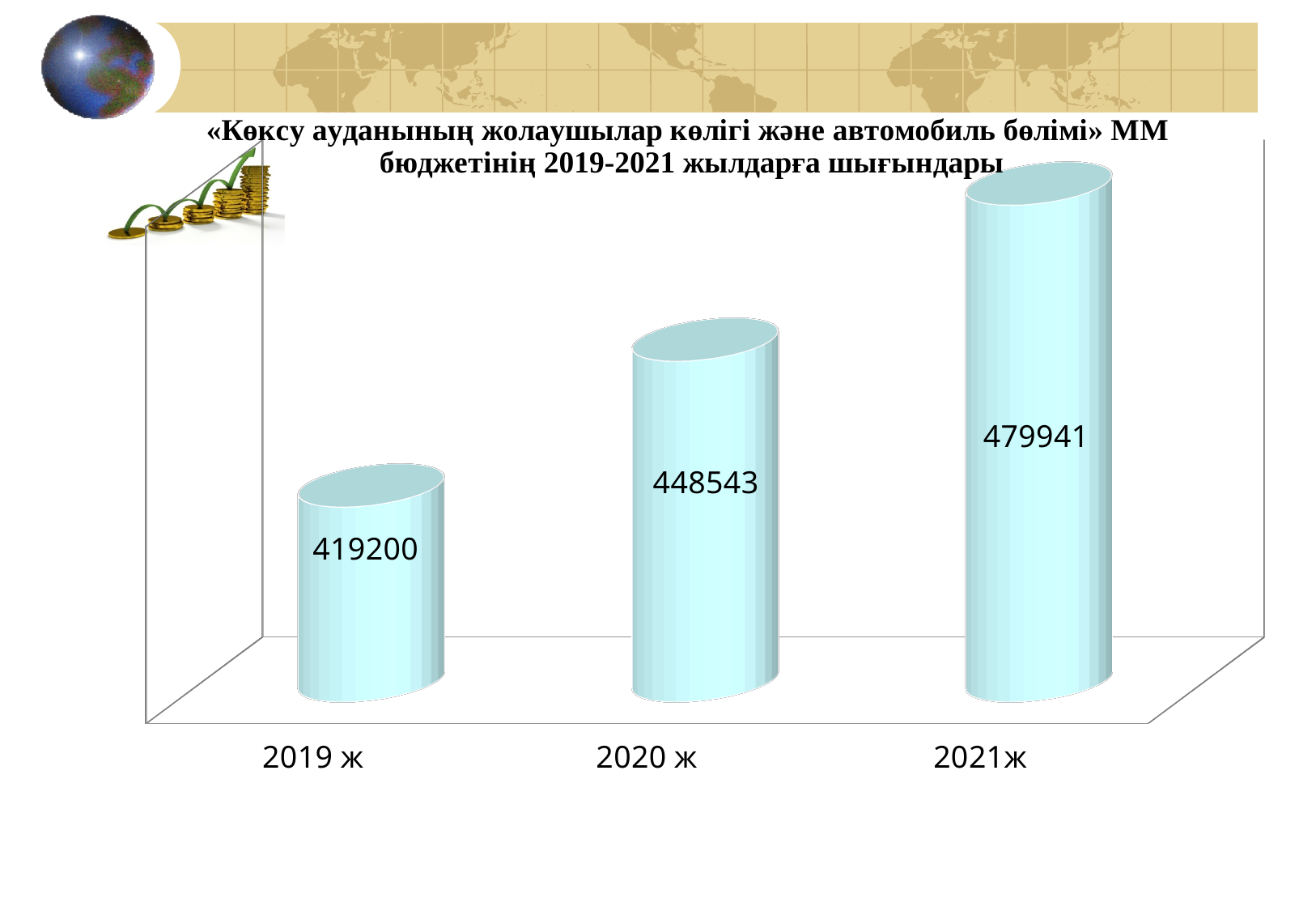
What is the difference between the values for 2020 ж and 2019 ж? 29343 What kind of chart is shown on the slide? bar chart Do the values rise or fall from 2019 ж to 2021ж? rise What is the difference between the values for 2021ж and 2020 ж? 31398 What is the value shown for 2020 ж? 448543 How many years (categories) are shown in the chart? 3 What is the value shown for 2019 ж? 419200 Which year has the highest value? 2021ж Which is larger, the value for 2020 ж or the value for 2019 ж? 2020 ж What is the value shown for 2021ж? 479941 What is the difference between the values for 2021ж and 2019 ж? 60741 Which year has the lowest value? 2019 ж